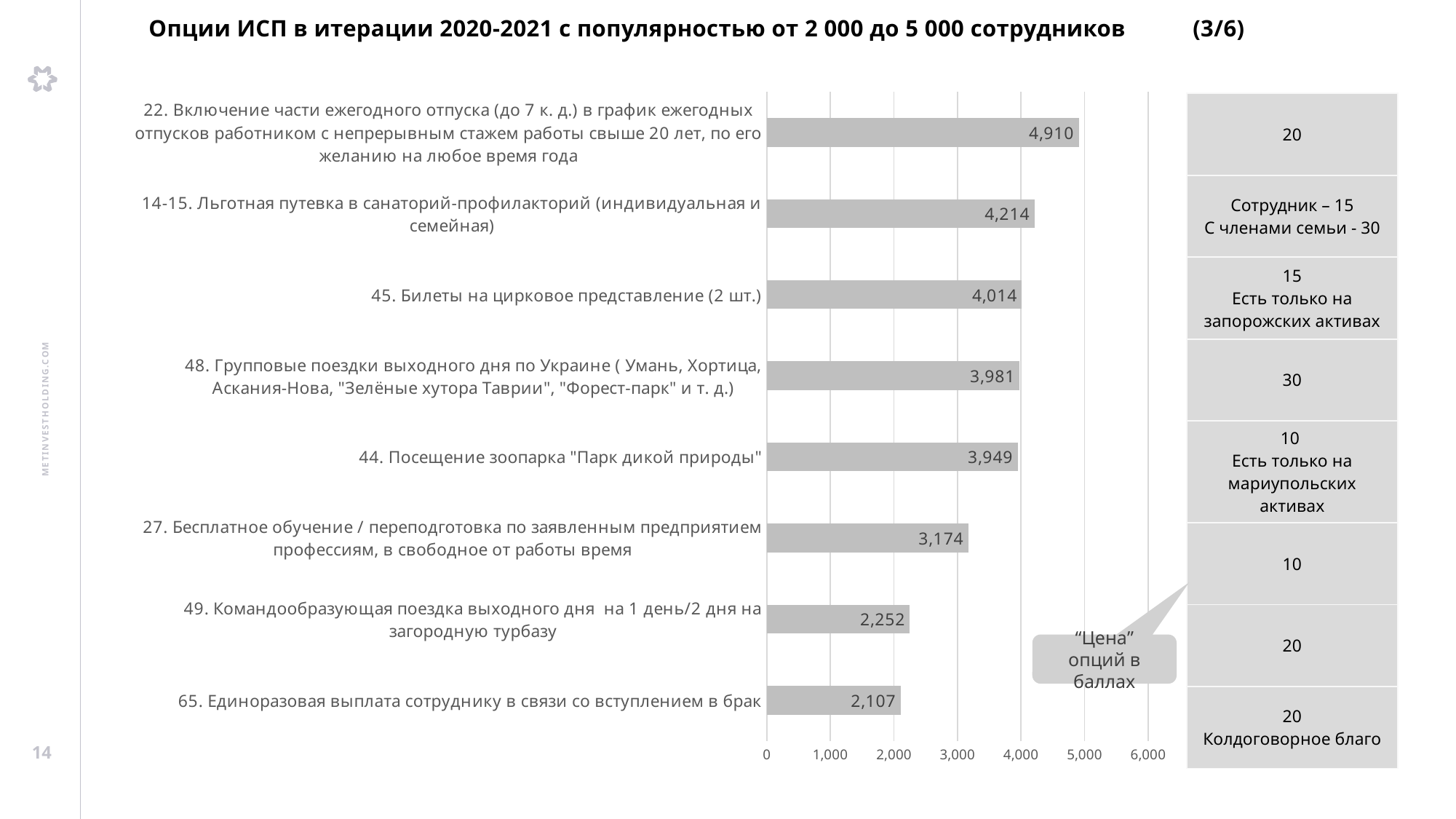
What is the difference between the values for option 22 (4,910) and option 65 (2,107)? 2,803 Is the value for option 44 (Посещение зоопарка) greater or less than 3,000? greater How many options (bars) are shown in the chart? 8 What is the value for option 27 (Бесплатное обучение / переподготовка)? 3,174 What is the value for option 45 (Билеты на цирковое представление)? 4,014 Which option has the lowest value? 65. Единоразовая выплата сотруднику в связи со вступлением в брак What type of chart is shown on the slide? Bar chart Which option has the highest value? 22. Включение части ежегодного отпуска (до 7 к. д.) в график ежегодных отпусков Which has a larger value: option 27 (Бесплатное обучение) or option 49 (Командообразующая поездка)? 27. Бесплатное обучение / переподготовка What is the value for option 65 (Единоразовая выплата сотруднику в связи со вступлением в брак)? 2,107 What is the difference between the values for option 14-15 (Льготная путевка) and option 45 (Билеты на цирковое представление)? 200 What is the maximum value shown on the horizontal axis? 6,000